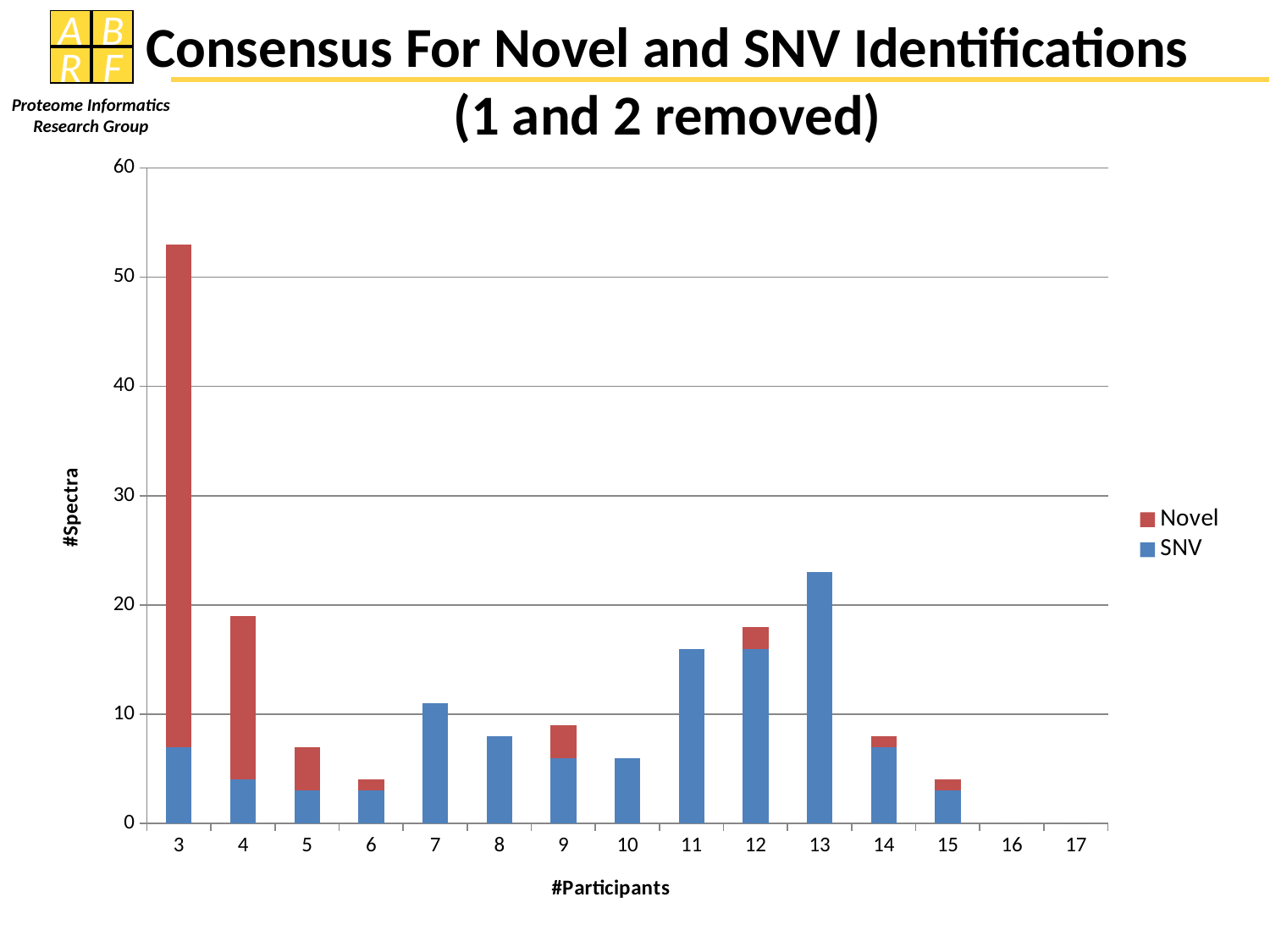
Is the total value for 12 participants greater or less than 20? less How many #Participants categories are shown on the x axis? 15 Is the value for 11 participants greater or less than 10? greater What is the title of the y axis? #Spectra Is the total value for 4 participants greater or less than 10? greater Which has a larger total number of spectra, 12 participants or 13 participants? 13 What kind of chart is shown on the slide? bar chart Which has a larger total number of spectra, 10 participants or 11 participants? 11 How many series does the legend list? 2 Which #Participants category has the highest total number of spectra? 3